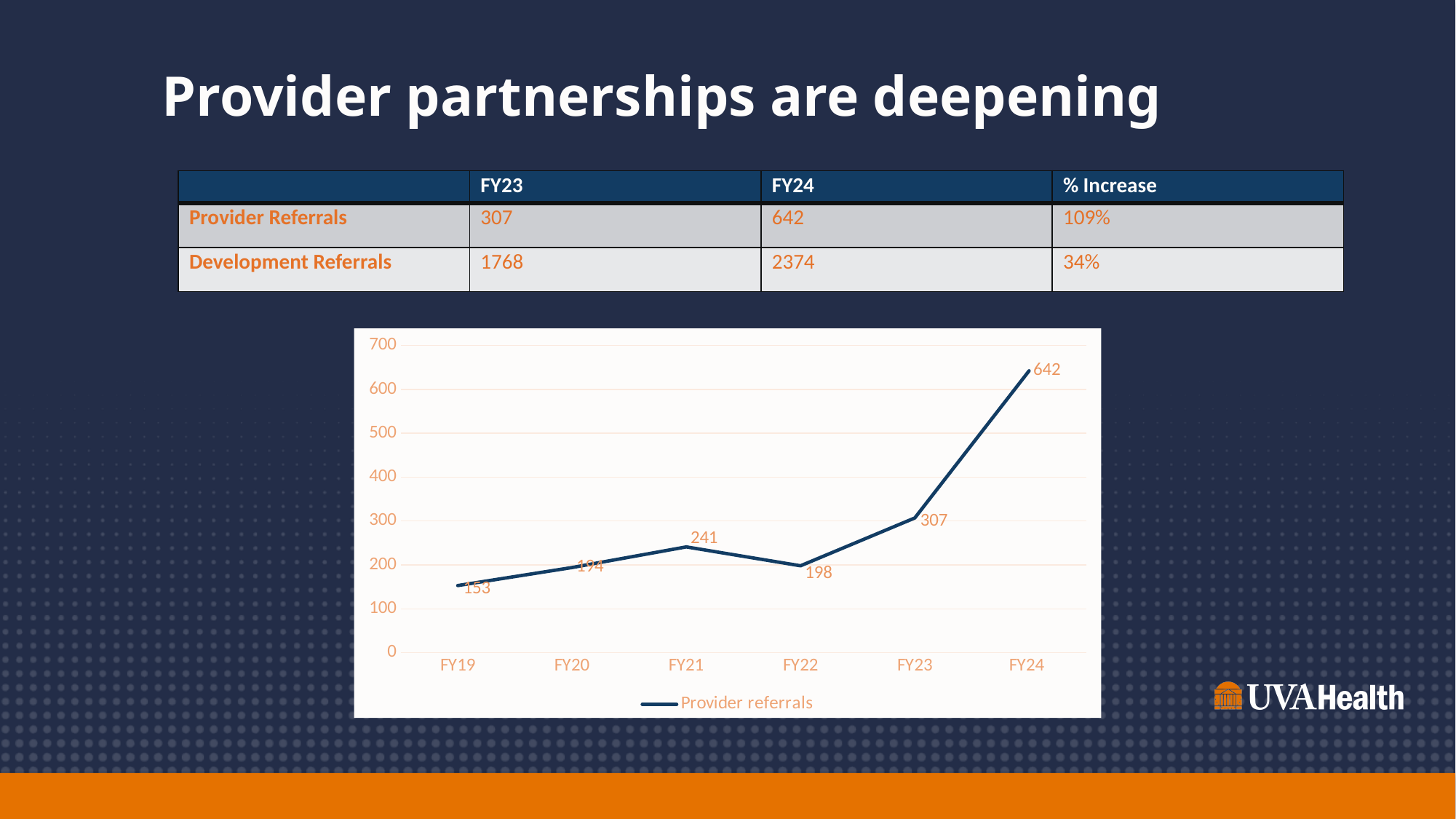
What is the value of Provider referrals for FY24? 642 What is the value of Provider referrals for FY22? 198 What is the name of the series shown in the chart legend? Provider referrals How many series does the chart legend list? 1 What is the difference in Provider referrals between FY24 and FY23? 335 What kind of chart is shown on the slide? line chart How many fiscal years are plotted on the x axis of the chart? 6 Which fiscal year has the lowest number of Provider referrals? FY19 Which is larger, Provider referrals in FY21 or in FY22? FY21 Which fiscal year has the highest number of Provider referrals? FY24 What is the value of Provider referrals for FY19? 153 Is the value for FY23 greater or less than 400? less